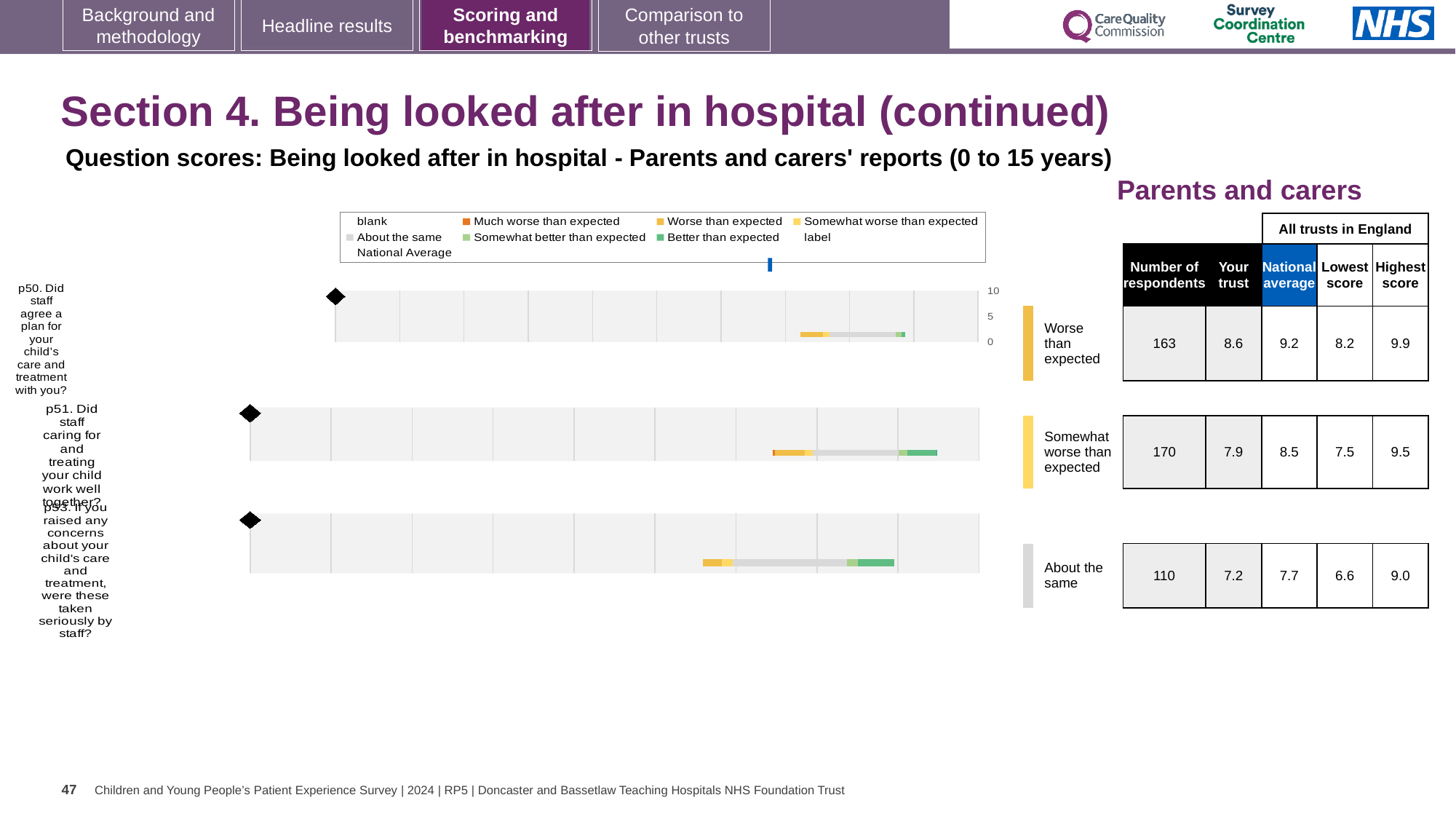
What is the highest score among all trusts in England for p50? 9.9 What is the lowest score among all trusts in England for p51? 7.5 For p50 (Did staff agree a plan for your child's care and treatment with you?), what is the number of respondents? 163 Which question has the highest number of respondents? p51 What kind of chart is used to show the question scores on this slide? bar chart How many entries does the chart legend list? 9 Which benchmark category is shown next to the p50 chart? Worse than expected Which has the larger 'Your trust' score, p50 or p51? p50 How many survey questions (p50, p51, p53) are plotted on the slide? 3 For p50, how much higher is the national average than the 'Your trust' score? 0.6 For p53 (If you raised any concerns about your child's care and treatment, were these taken seriously by staff?), what is the national average score? 7.7 For p51 (Did staff caring for and treating your child work well together?), what is the 'Your trust' score? 7.9